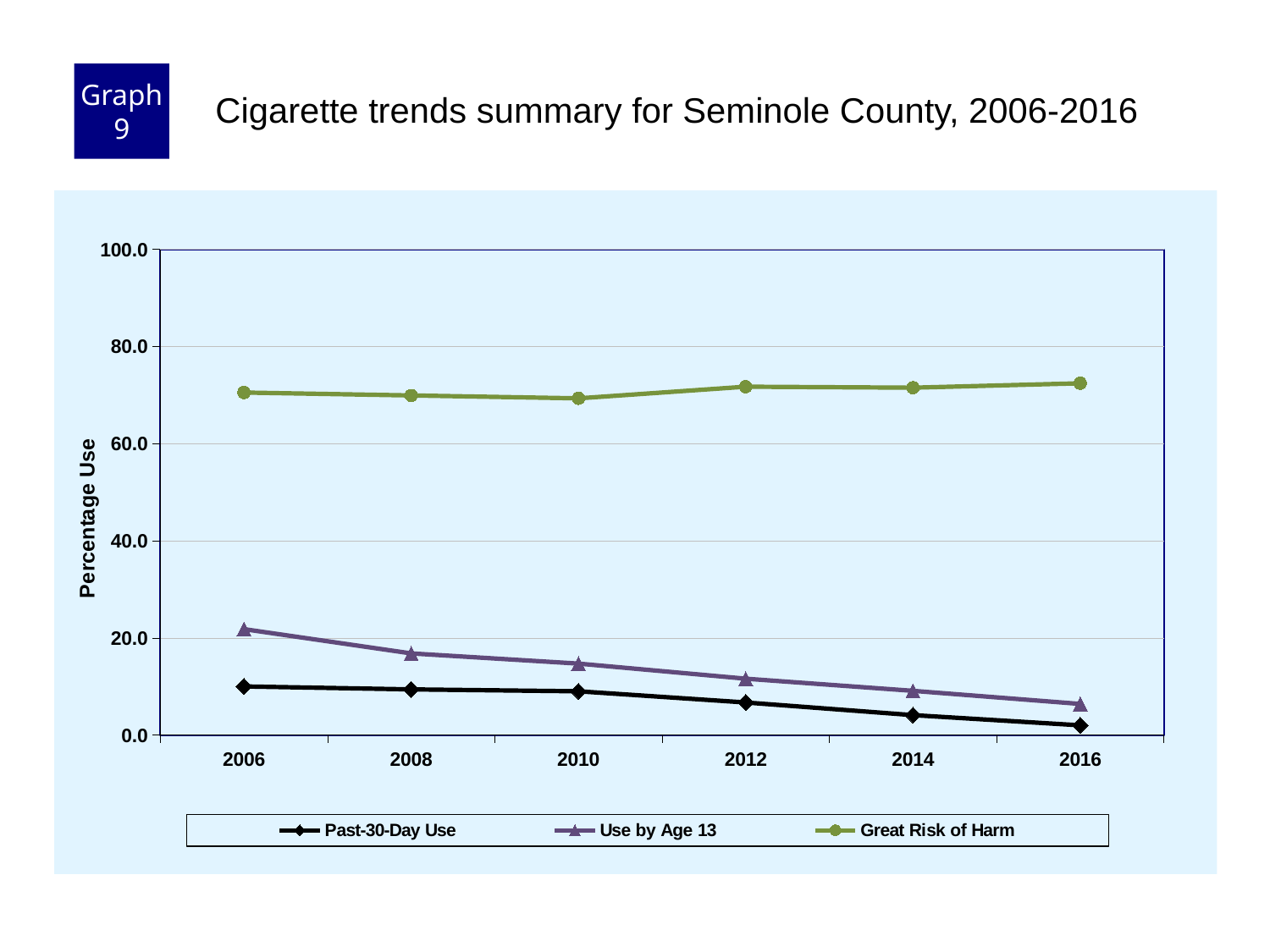
Does the Use by Age 13 line rise or fall from 2006 to 2016? fall How many series does the legend list? 3 In which year is Past-30-Day Use lowest? 2016 What is the label on the y axis? Percentage Use How many years are plotted along the x axis? 6 Is the value for Use by Age 13 in 2016 greater or less than 20.0? less Is the value for Past-30-Day Use in 2006 greater or less than 20.0? less In which year is Use by Age 13 highest? 2006 What kind of chart is shown on the slide? line chart Does the Past-30-Day Use line rise or fall from 2006 to 2016? fall Is the value for Great Risk of Harm in 2006 greater or less than 60.0? greater In 2012, which is larger: Great Risk of Harm or Past-30-Day Use? Great Risk of Harm